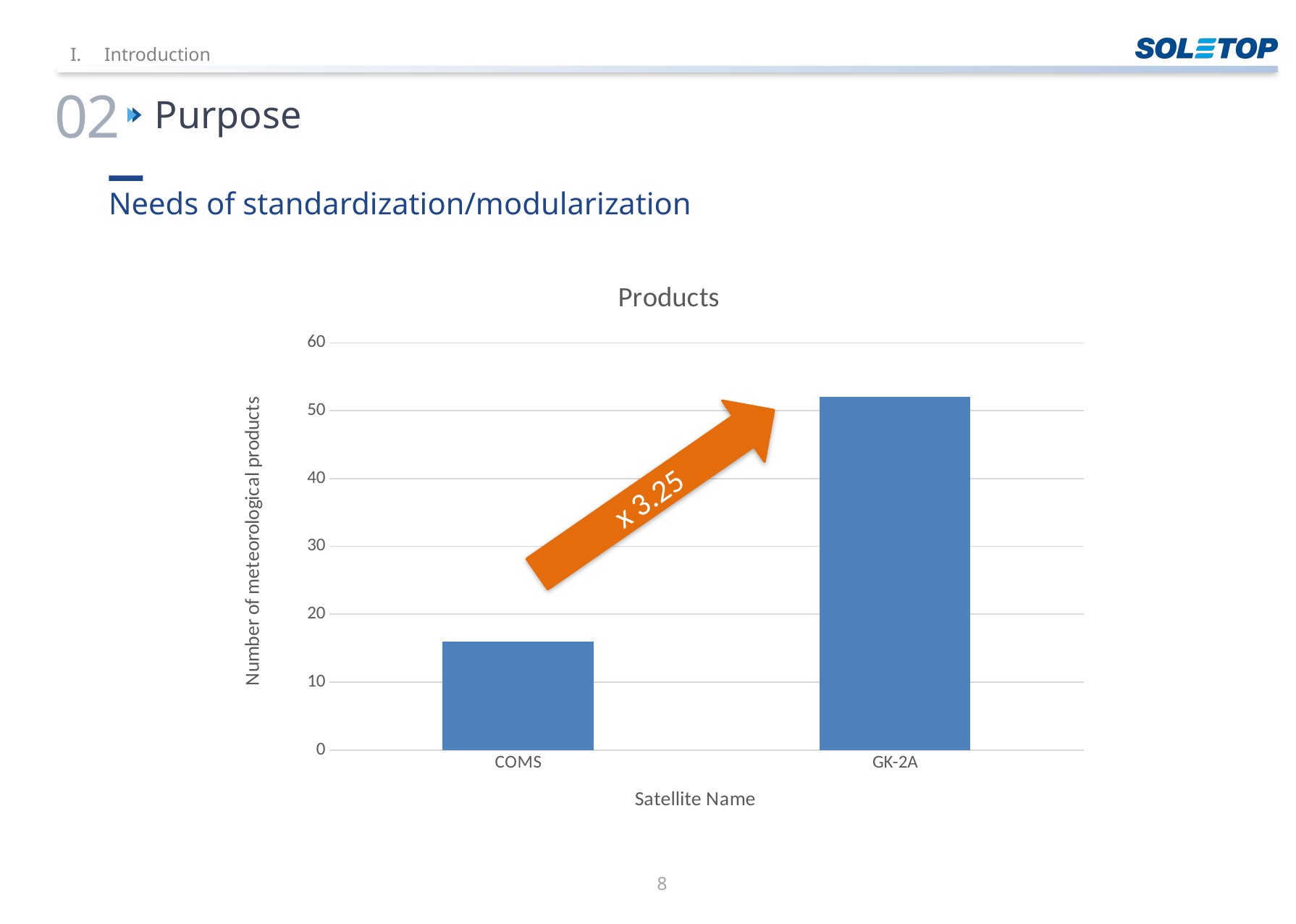
How many satellites (categories) are plotted in the chart? 2 Is the value for COMS greater or less than 10? greater Which satellite has the lowest number of meteorological products? COMS Which has more meteorological products, COMS or GK-2A? GK-2A Is the value for COMS greater or less than 20? less What multiplication factor is written on the orange arrow in the chart? x 3.25 Is the value for GK-2A greater or less than 50? greater What kind of chart is shown on the slide? bar chart What is the title of the chart? Products Which satellite has the highest number of meteorological products? GK-2A